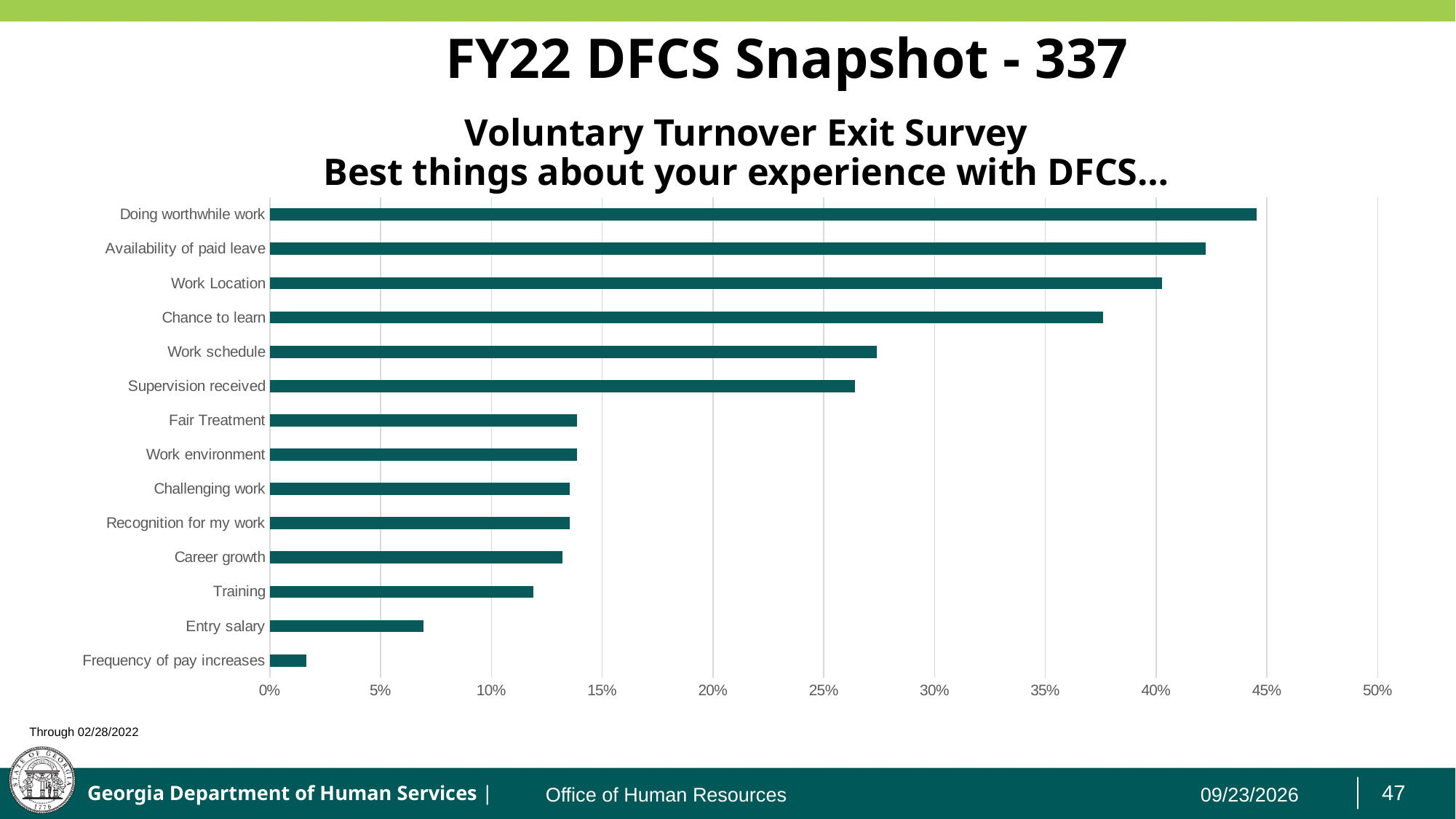
Which category has the highest value? Doing worthwhile work Is the value for Work schedule greater or less than 25%? greater What is the title of the chart? Voluntary Turnover Exit Survey Best things about your experience with DFCS… How many categories are plotted in the chart? 14 Which category has the lowest value? Frequency of pay increases Which is larger, the value for Chance to learn or the value for Work schedule? Chance to learn Which is larger, the value for Training or the value for Entry salary? Training Is the value for Doing worthwhile work greater or less than 40%? greater Is the value for Entry salary greater or less than 5%? greater What kind of chart is shown on the slide? Bar chart